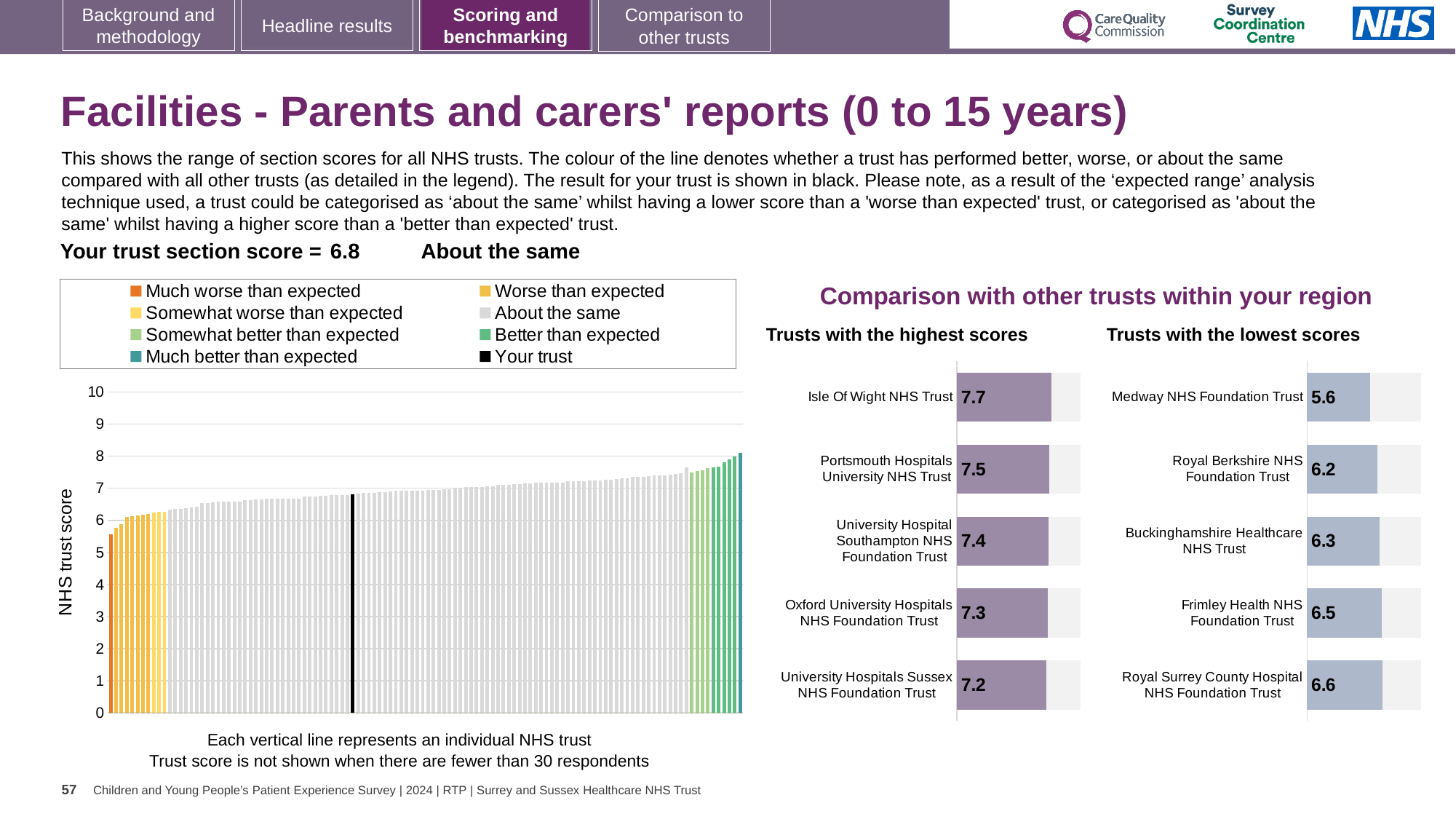
In the 'Trusts with the lowest scores' chart, what is the difference between the scores of Royal Surrey County Hospital NHS Foundation Trust and Medway NHS Foundation Trust? 1.0 How many entries does the legend of the NHS trust score chart on the left list? 8 In the 'Trusts with the highest scores' chart, what is the score for Isle Of Wight NHS Trust? 7.7 In the 'Trusts with the highest scores' chart, what is the difference between the scores of Isle Of Wight NHS Trust and University Hospitals Sussex NHS Foundation Trust? 0.5 In the NHS trust score chart on the left, is the value of the lowest (leftmost) bar greater or less than 6? less In the 'Trusts with the lowest scores' chart, what is the score for Medway NHS Foundation Trust? 5.6 In the NHS trust score chart on the left, is the value for the black 'Your trust' bar greater or less than 7? less In the 'Trusts with the highest scores' chart, which trust has the highest score? Isle Of Wight NHS Trust In the 'Trusts with the highest scores' chart, how many trusts are shown? 5 In the 'Trusts with the lowest scores' chart, which trust has the lowest score? Medway NHS Foundation Trust In the 'Trusts with the lowest scores' chart, which has the higher score: Frimley Health NHS Foundation Trust or Royal Berkshire NHS Foundation Trust? Frimley Health NHS Foundation Trust What kind of chart is the 'Trusts with the lowest scores' chart? bar chart